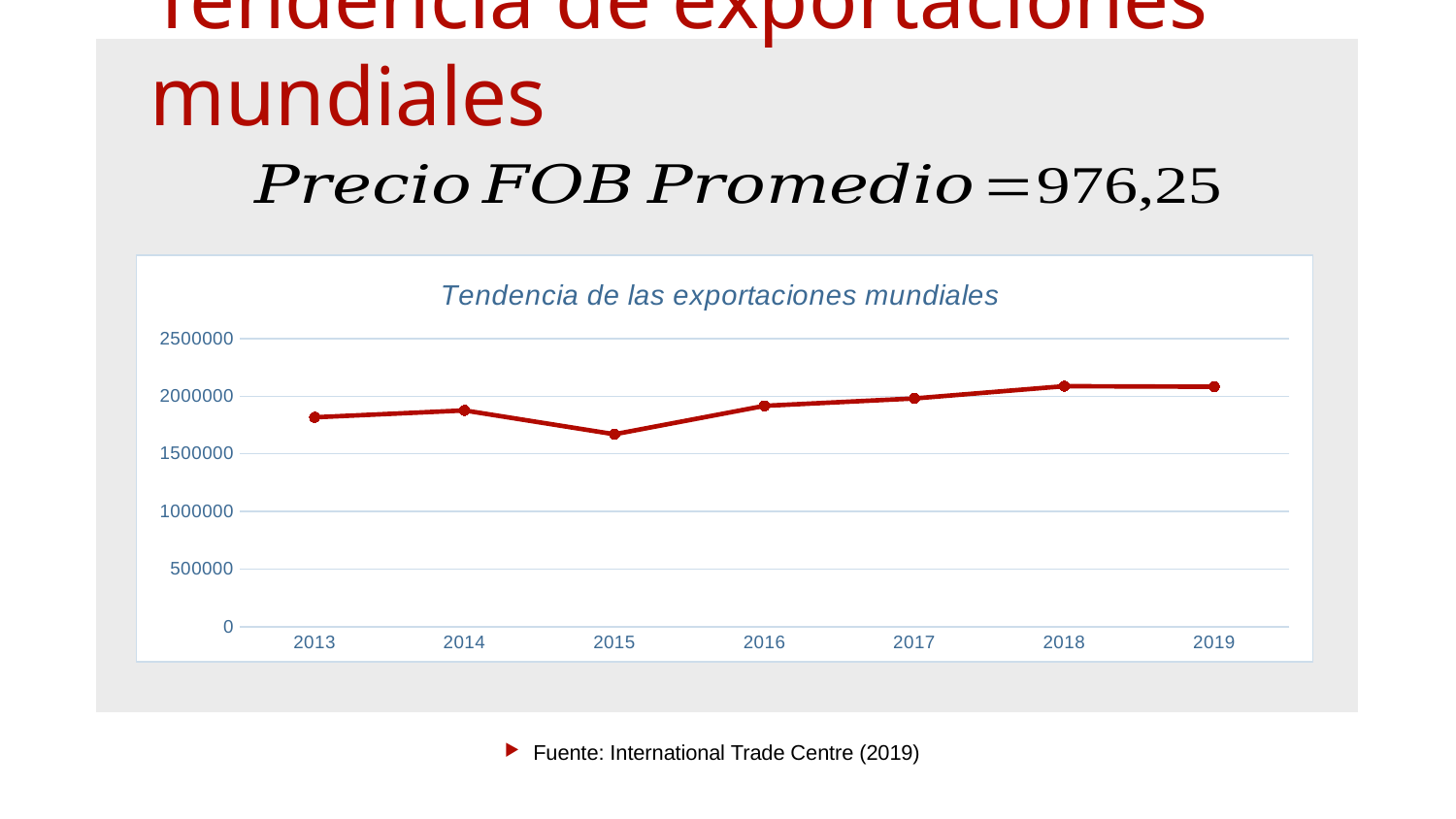
Which year has the lowest value in the chart? 2015 Is the value for 2018 greater or less than 2000000? greater Do the values rise or fall from 2015 to 2018? rise Which year has the larger value, 2014 or 2015? 2014 Is the value for 2013 greater or less than 1500000? greater How many years are plotted on the x axis of the chart? 7 What kind of chart is shown on the slide? line chart Is the value for 2016 greater or less than 2000000? less Which year has the larger value, 2013 or 2018? 2018 What colour is the line in the chart? red What is the title of the chart? Tendencia de las exportaciones mundiales